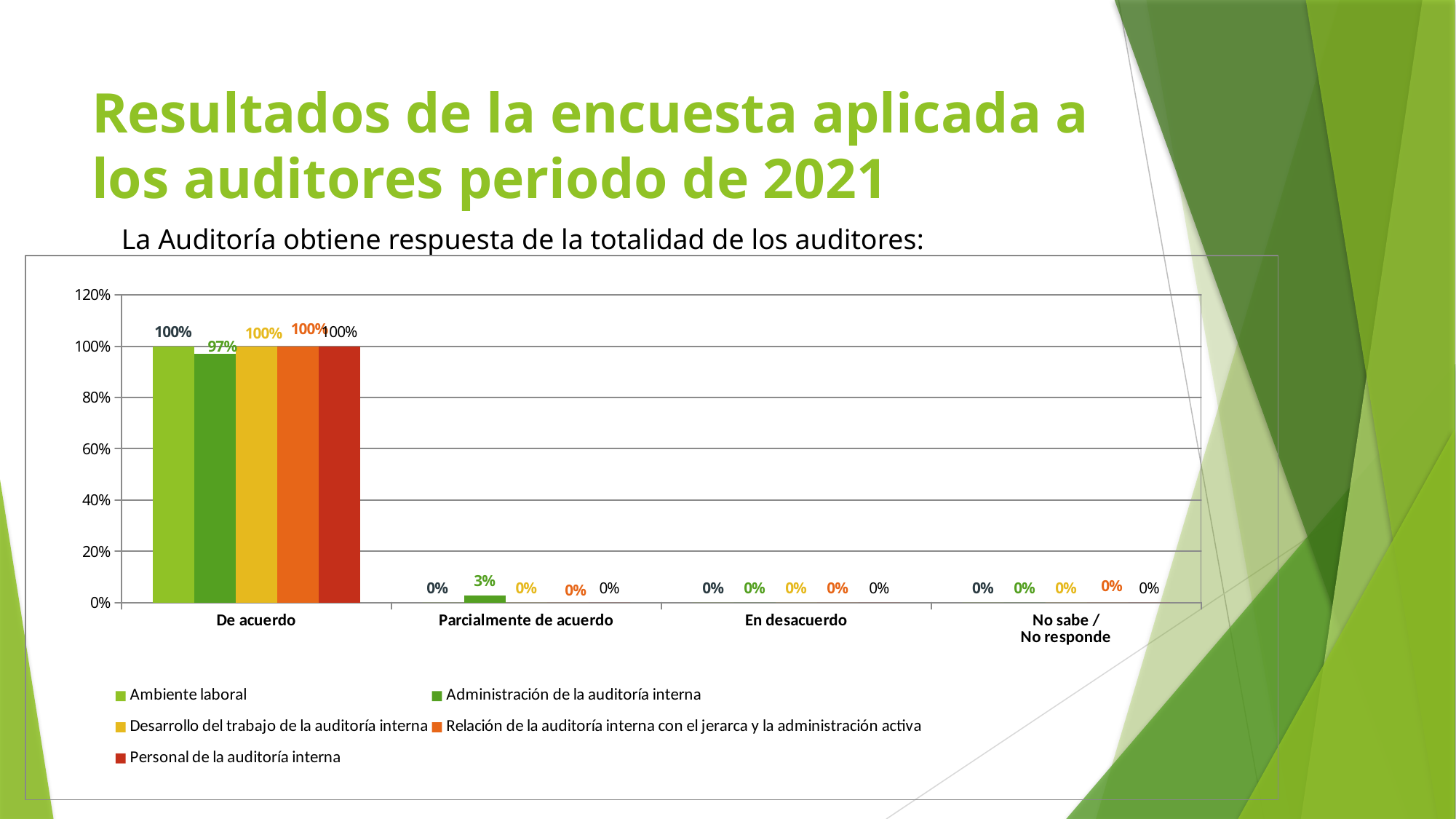
What is the value for 'Ambiente laboral' in the 'De acuerdo' category? 100% What is the value for 'Personal de la auditoría interna' in the 'En desacuerdo' category? 0% What is the value for 'Administración de la auditoría interna' in the 'De acuerdo' category? 97% How many categories are shown on the x axis of the chart? 4 How many series does the chart's legend list? 5 Which series has the lowest value in the 'De acuerdo' category? Administración de la auditoría interna Which legend entry is shown in red? Personal de la auditoría interna What is the difference between the 'Ambiente laboral' value and the 'Administración de la auditoría interna' value in the 'De acuerdo' category? 3% What kind of chart is shown on the slide? bar chart Which is larger for 'Administración de la auditoría interna': the value for 'De acuerdo' or the value for 'Parcialmente de acuerdo'? De acuerdo What is the value for 'Administración de la auditoría interna' in the 'Parcialmente de acuerdo' category? 3% Which series has the highest value in the 'Parcialmente de acuerdo' category? Administración de la auditoría interna